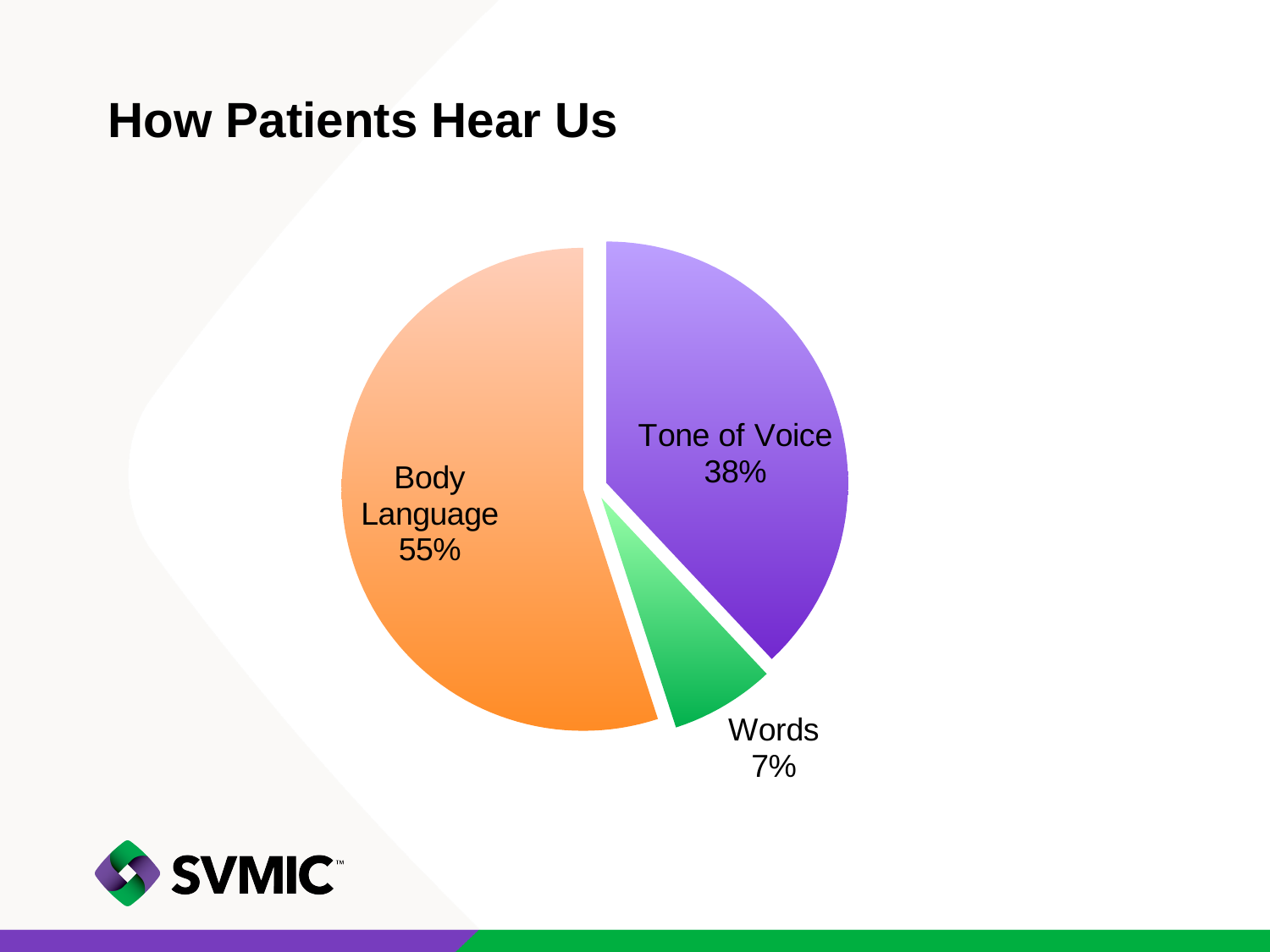
What is the difference in percentage points between Body Language and Tone of Voice? 17 What is the difference in percentage points between Tone of Voice and Words? 31 What percentage is shown for Body Language? 55% What kind of chart is shown on the slide? pie chart Which slice of the pie is the smallest? Words Which slice of the pie is the largest? Body Language What percentage is shown for Words? 7% What is the title of the slide containing the pie chart? How Patients Hear Us How many slices does the pie chart have? 3 What percentage is shown for Tone of Voice? 38% What colour is the Words slice? green Which is larger, Tone of Voice or Words? Tone of Voice